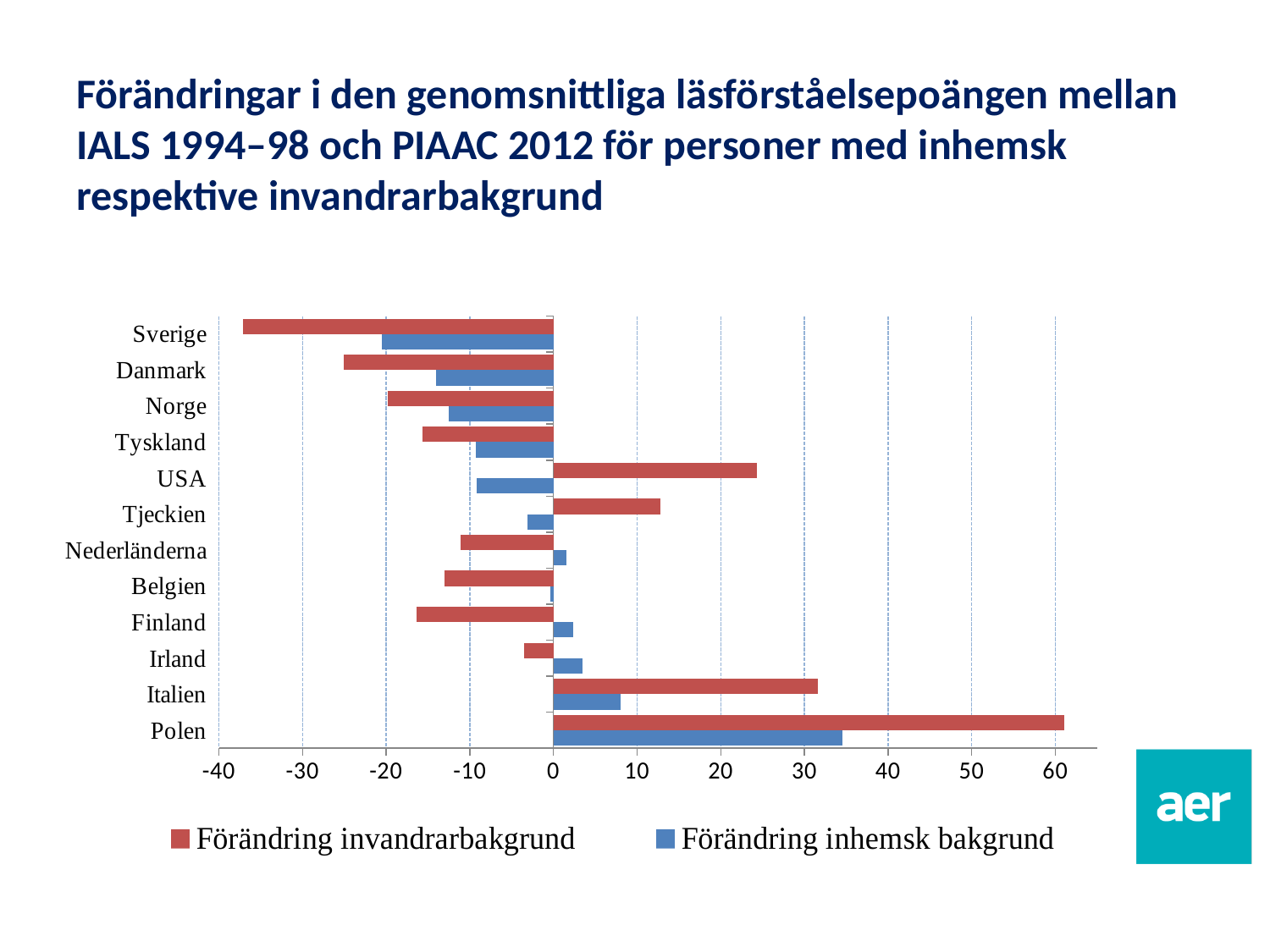
Is the value for USA in the Förändring invandrarbakgrund series greater or less than 20? greater What kind of chart is shown on the slide? bar chart Which country has the lowest value for Förändring inhemsk bakgrund? Sverige How many countries are listed on the chart? 12 Is the value for Sverige in the Förändring invandrarbakgrund series greater or less than -30? less Which country has the highest value for Förändring inhemsk bakgrund? Polen Which country has the lowest value for Förändring invandrarbakgrund? Sverige What colour are the bars for the Förändring invandrarbakgrund series? red Which has the larger value for Förändring invandrarbakgrund, Italien or USA? Italien How many series does the legend list? 2 Which country has the highest value for Förändring invandrarbakgrund? Polen Is the value for Polen in the Förändring invandrarbakgrund series greater or less than 50? greater